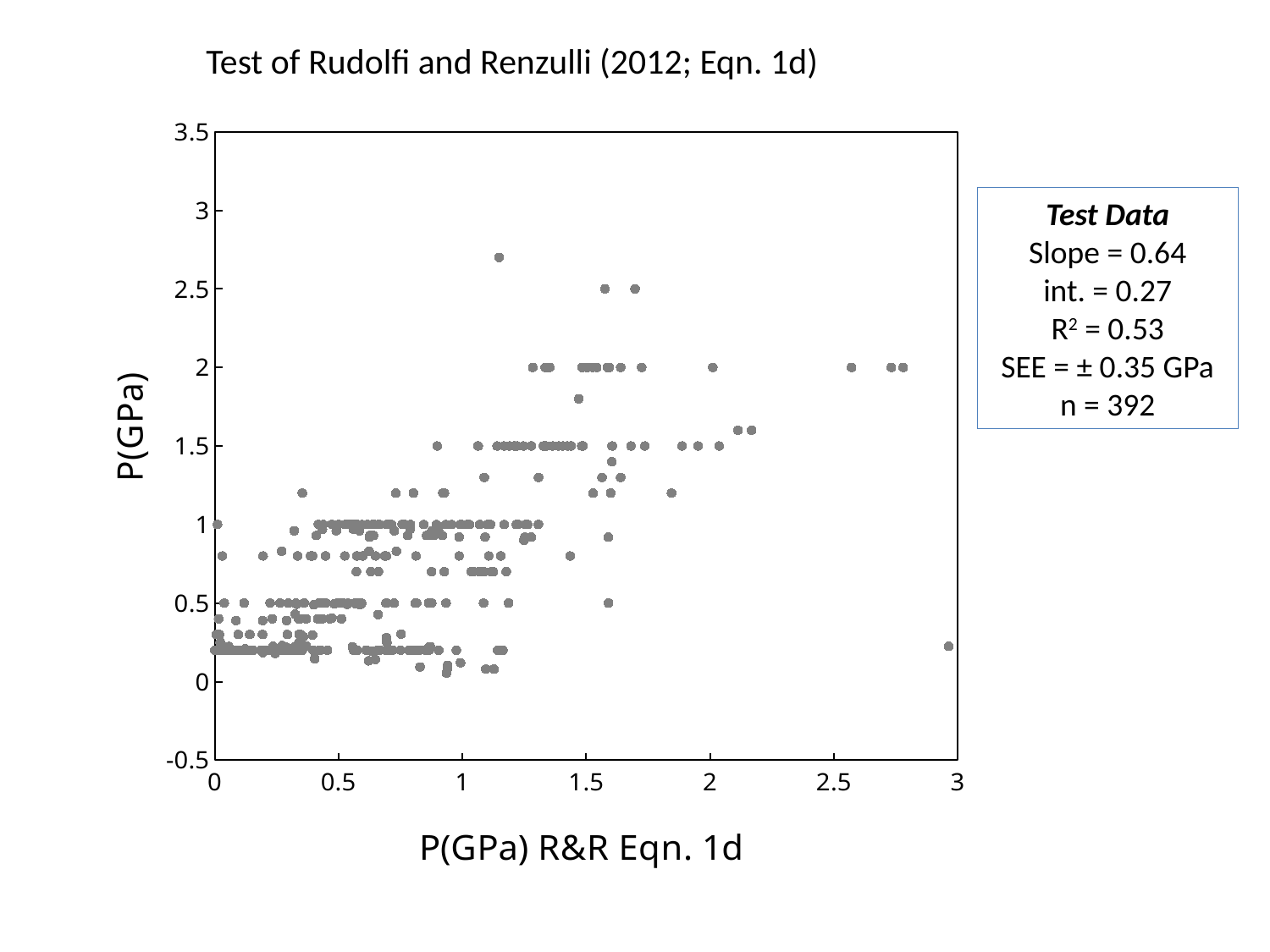
What kind of chart is shown on the slide? scatter plot Do the P(GPa) values generally rise or fall as P(GPa) R&R Eqn. 1d increases along the x axis? rise According to the text box, how many data points (n) are plotted? 392 What is the maximum value shown on the y axis? 3.5 What intercept (int.) is reported in the text box? 0.27 Is the P(GPa) value of the rightmost point (near x = 3) greater or less than 0.5? less What is the label of the x axis? P(GPa) R&R Eqn. 1d What SEE value is reported in the text box? ± 0.35 GPa Is the P(GPa) value of the highest point on the chart greater or less than 2.5? greater What is the title of the chart? Test of Rudolfi and Renzulli (2012; Eqn. 1d) What slope is reported for the test data in the text box? 0.64 What R² value is reported in the text box? 0.53